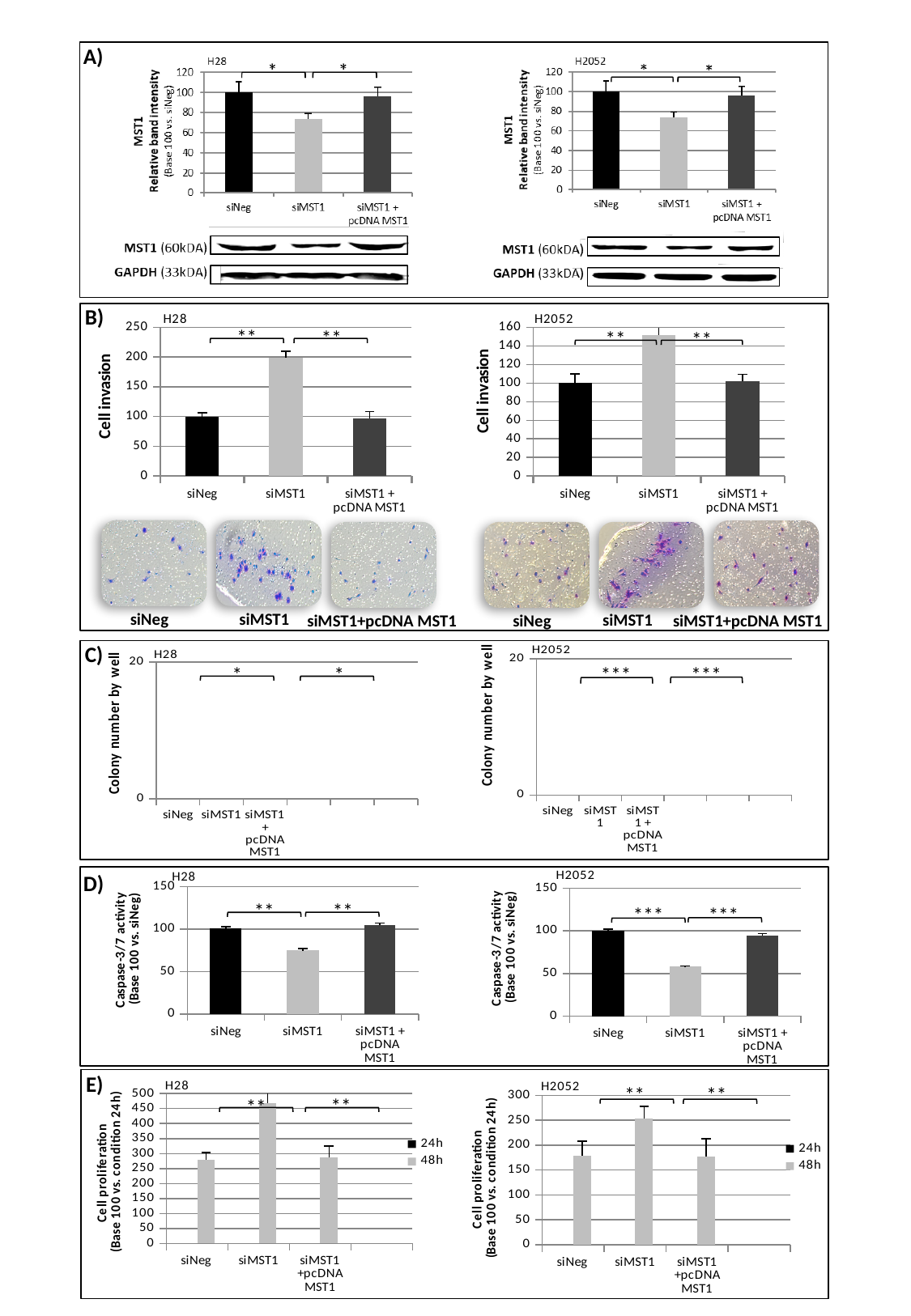
In panel D, on the H2052 caspase-3/7 activity chart, which category has the lowest bar? siMST1 In panel E, on the H2052 cell proliferation chart, is the 48h value for siMST1 greater or less than 200? greater In panel B, on the H28 cell invasion chart, which category has the highest bar? siMST1 In panel B, on the H2052 cell invasion chart, is the value for siMST1 greater or less than 120? greater In panel E, on the H28 cell proliferation chart, is the 48h value for siMST1 greater or less than 400? greater In panel E, how many series does the legend of the H28 cell proliferation chart list? 2 In panel B, how many categories are shown on the x axis of the H28 cell invasion chart? 3 What kind of chart is the H28 cell invasion chart in panel B? bar chart In panel E, on the H2052 cell proliferation chart, which category has the highest bar? siMST1 In panel D, on the H28 caspase-3/7 activity chart, which is larger, siNeg or siMST1? siNeg